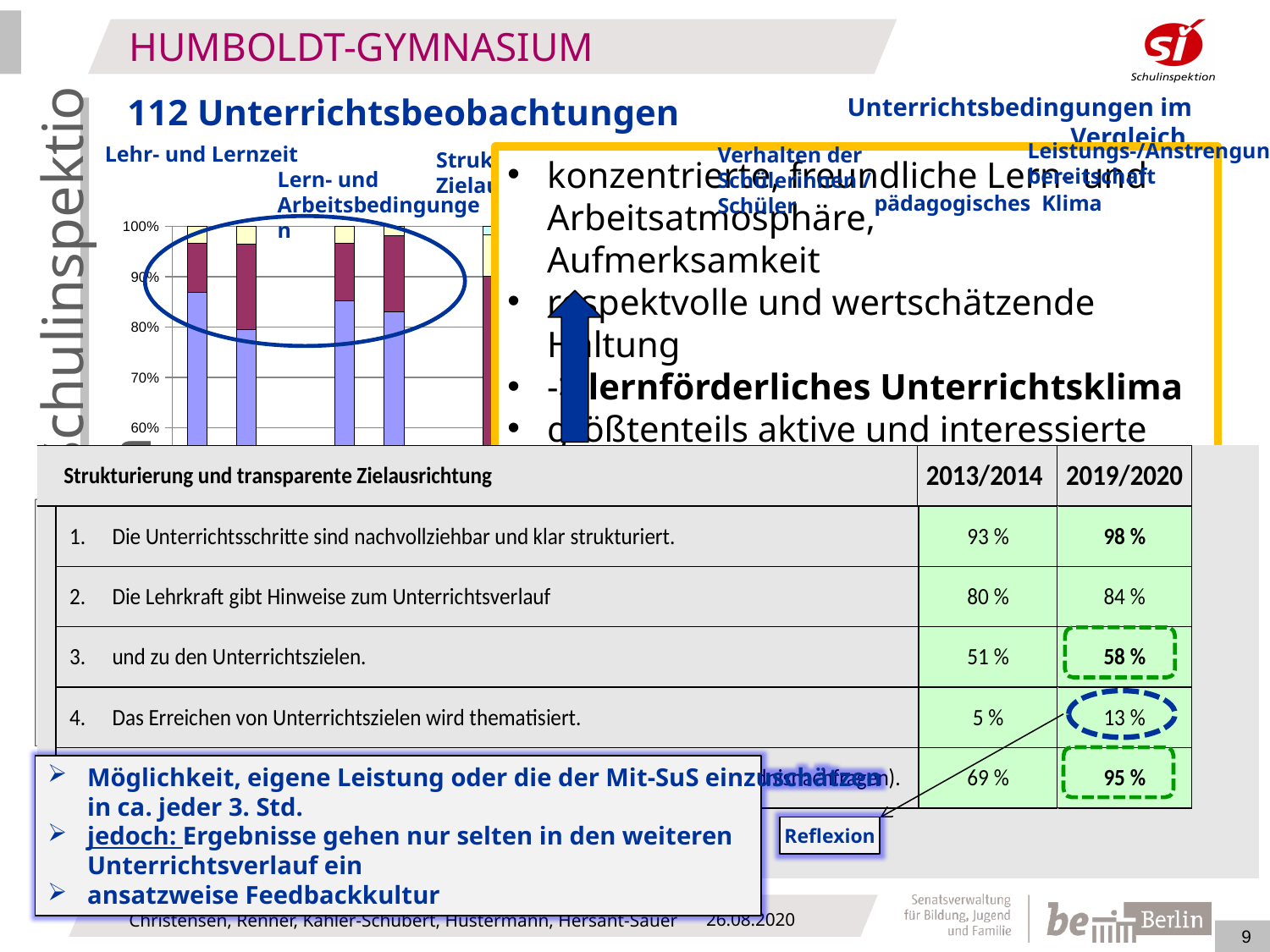
What is the lowest value shown on the y-axis of the bar chart? 60% What kind of chart is shown on the left of the slide? bar chart In the bar chart, is the top of the light blue segment of the first bar greater or less than 80%? greater What is the highest value shown on the y-axis of the bar chart? 100% In the bar chart, is the top of the light blue segment of the second bar greater or less than 90%? less